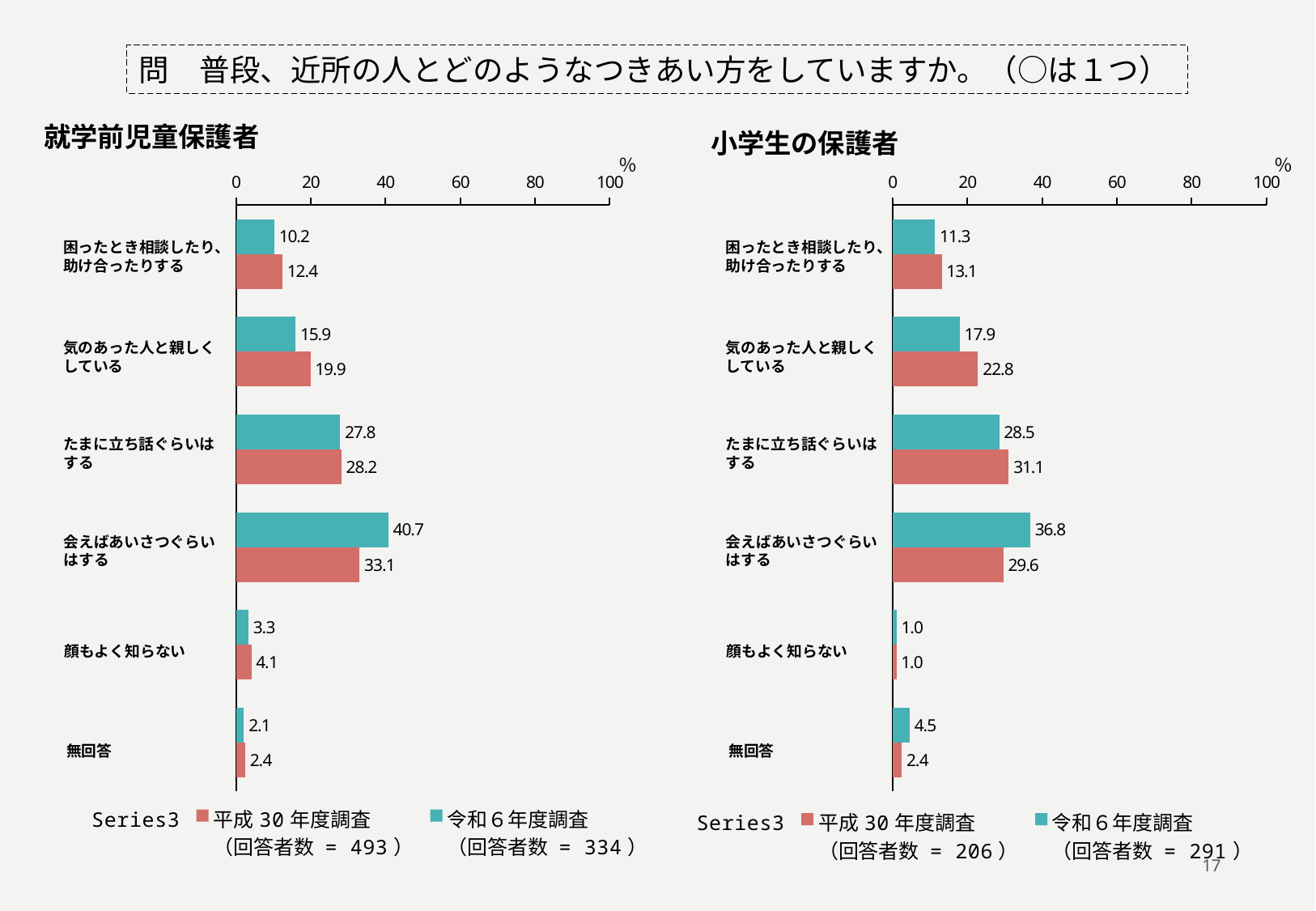
In the 小学生の保護者 chart, how many respondents does the legend give for the 令和６年度調査? 291 How many categories are shown in the 小学生の保護者 chart? 6 In the 小学生の保護者 chart, which is larger for 気のあった人と親しくしている: the 平成30年度調査 value or the 令和６年度調査 value? 平成30年度調査 In the 就学前児童保護者 chart, what is the 平成30年度調査 value for 気のあった人と親しくしている? 19.9 In the 就学前児童保護者 chart, what is the 令和６年度調査 value for 会えばあいさつぐらいはする? 40.7 In the 小学生の保護者 chart, what is the 令和６年度調査 value for 無回答? 4.5 In the 小学生の保護者 chart, what is the 平成30年度調査 value for たまに立ち話ぐらいはする? 31.1 What type of chart is the 就学前児童保護者 chart? bar chart In the 小学生の保護者 chart, which category has the lowest 平成30年度調査 value? 顔もよく知らない In the 就学前児童保護者 chart, what is the difference between the 令和６年度調査 and 平成30年度調査 values for 会えばあいさつぐらいはする? 7.6 In the 就学前児童保護者 chart, which category has the highest 令和６年度調査 value? 会えばあいさつぐらいはする In the 就学前児童保護者 chart, is the 令和６年度調査 value for たまに立ち話ぐらいはする greater or less than 20? greater